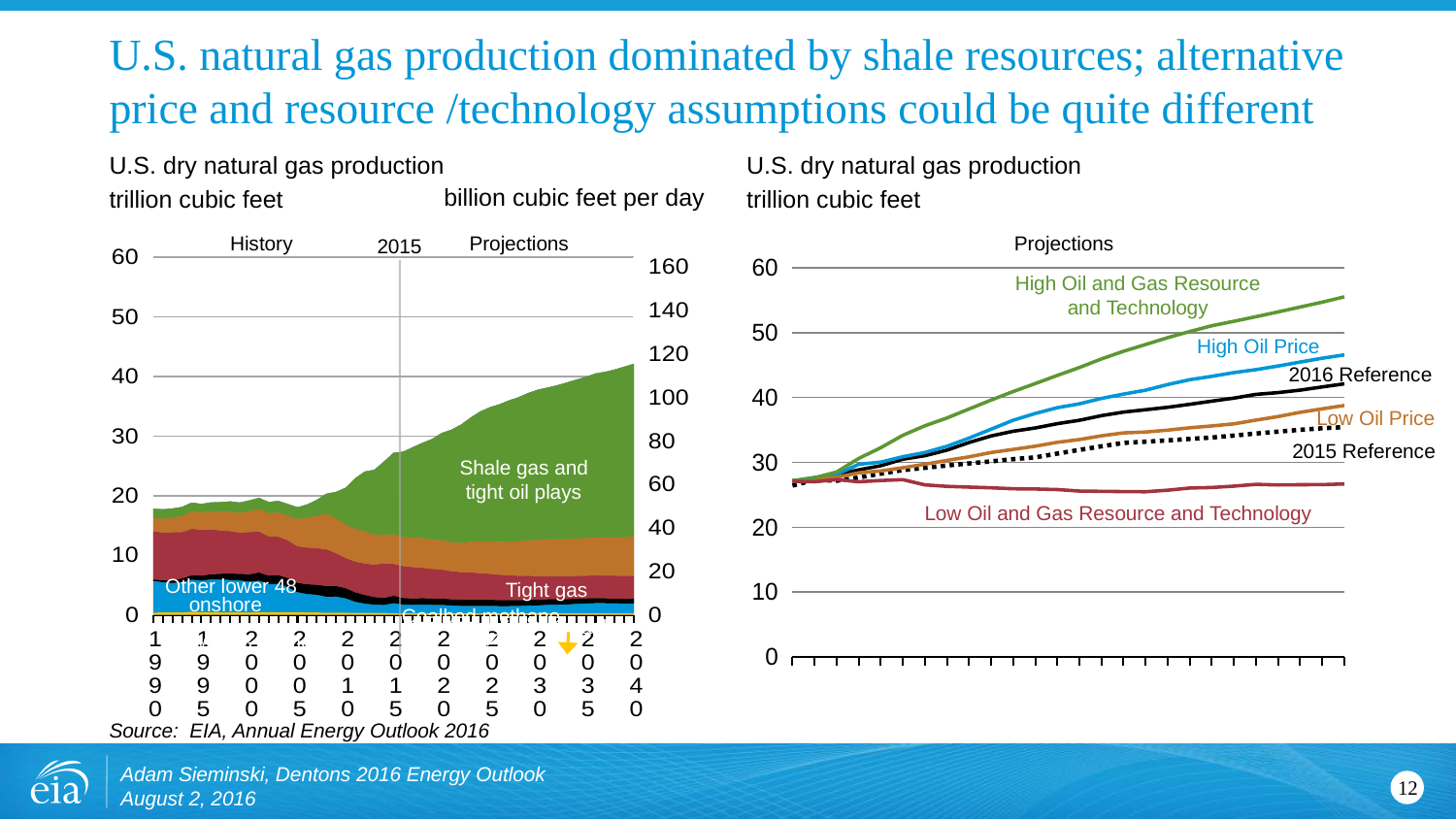
In the right chart, which is larger in 2040: the 2016 Reference case or the 2015 Reference case? 2016 Reference What kind of chart is the right chart showing the projection scenarios? Line chart In the left chart, which source accounts for the largest share of production in 2040? Shale gas and tight oil plays In the right chart, how many scenario lines are plotted? 6 In the right chart, which scenario has the highest production in 2040? High Oil and Gas Resource and Technology In the left chart, is total U.S. dry natural gas production in 2040 greater or less than 40 trillion cubic feet? greater What kind of chart is the left chart, 'U.S. dry natural gas production' by source? Stacked area chart In the right chart, which scenario has the lowest production in 2040? Low Oil and Gas Resource and Technology In the right chart, is the 2040 value for the High Oil and Gas Resource and Technology scenario greater or less than 50 trillion cubic feet? greater In the right chart, is the 2040 value for the Low Oil and Gas Resource and Technology scenario greater or less than 30 trillion cubic feet? less In the right chart, which scenario is drawn as a dotted line? 2015 Reference